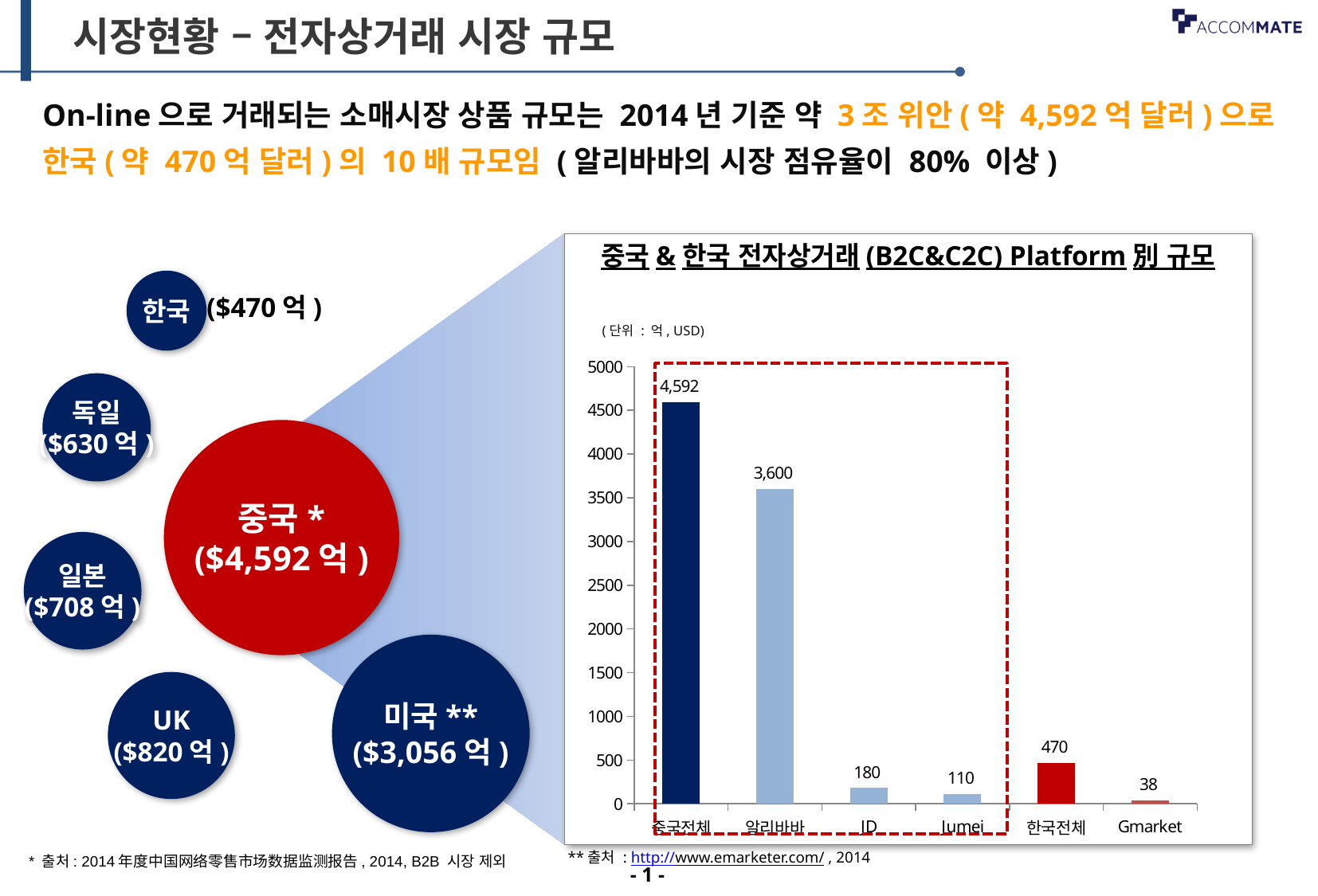
In the bar chart, what is the value for 한국전체? 470 In the bar chart, what is the difference between 중국전체 and 알리바바? 992 In the bar chart, which category has the highest value? 중국전체 In the bar chart, which category has the lowest value? Gmarket What type of chart is shown on the right side of the slide? bar chart In the bar chart, what is the value for JD? 180 In the bar chart, what is the value for Jumei? 110 In the bar chart, what is the value for Gmarket? 38 In the bar chart, what is the value for 알리바바? 3,600 How many categories are shown on the x axis of the bar chart? 6 In the bar chart, which is larger, 한국전체 or JD? 한국전체 In the bar chart, what is the value for 중국전체? 4,592